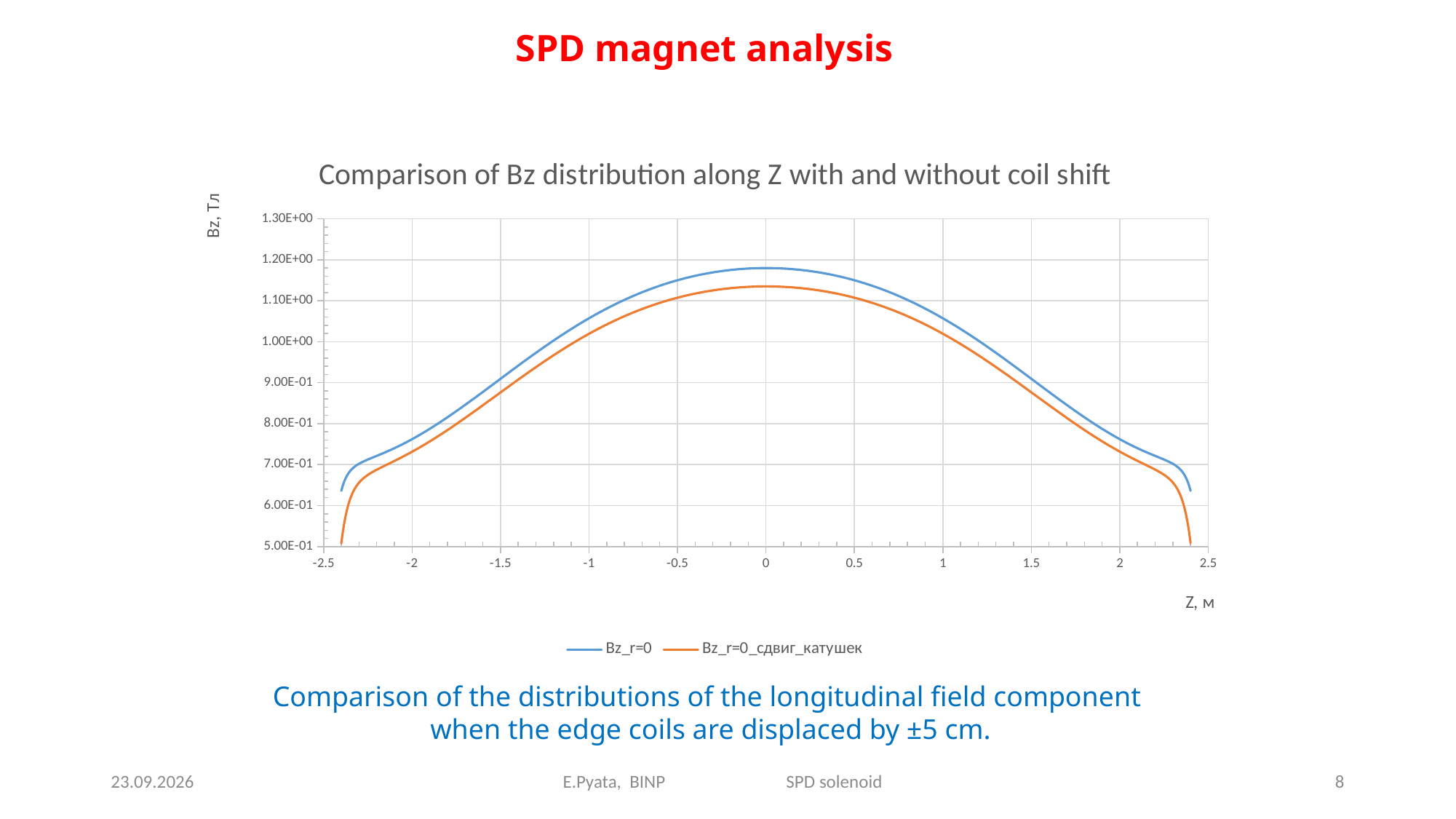
At Z = 0, which series has the higher value, Bz_r=0 or Bz_r=0_сдвиг_катушек? Bz_r=0 Is the value of Bz_r=0 at Z = 2 greater or less than 8.00E-01? less What is the title of the chart? Comparison of Bz distribution along Z with and without coil shift Is the value of Bz_r=0 at Z = 0 greater or less than 1.10E+00? greater What are the two series named in the legend? Bz_r=0 and Bz_r=0_сдвиг_катушек How many series does the legend list? 2 What kind of chart is shown on the slide? line chart Is the value of Bz_r=0 at Z = 1 greater or less than 1.00E+00? greater Do the values of Bz_r=0_сдвиг_катушек rise or fall as Z goes from -2 to 0? rise Do the values of Bz_r=0 rise or fall as Z goes from 0 to 2? fall